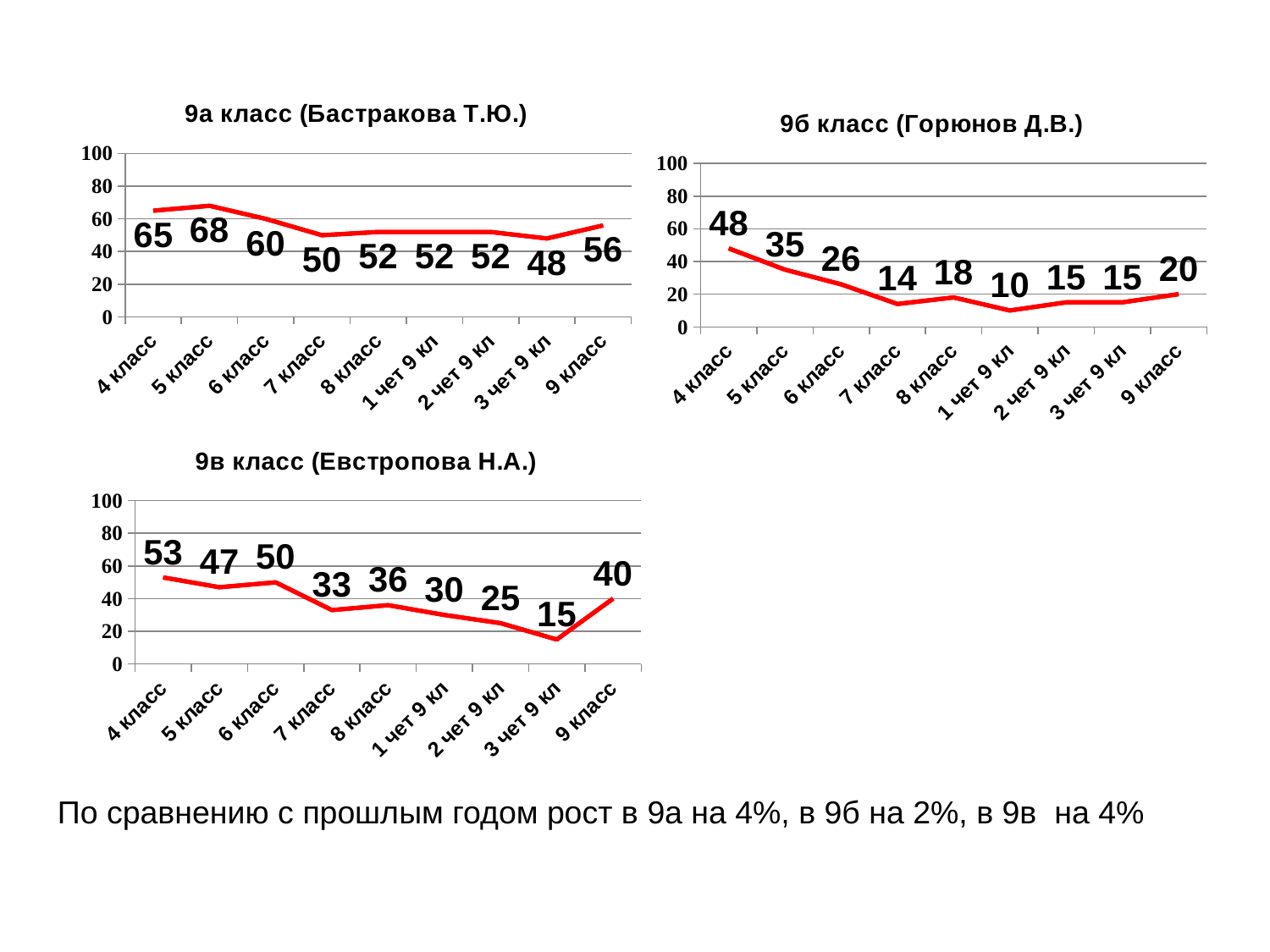
In the chart titled "9в класс (Евстропова Н.А.)", what is the difference between the values for 4 класс and 3 чет 9 кл? 38 In the chart titled "9в класс (Евстропова Н.А.)", what is the value for 8 класс? 36 What kind of chart is the chart titled "9б класс (Горюнов Д.В.)"? line chart In the chart titled "9б класс (Горюнов Д.В.)", do the values generally rise or fall from 4 класс to 7 класс? fall In the chart titled "9б класс (Горюнов Д.В.)", what is the value for 1 чет 9 кл? 10 In the chart titled "9в класс (Евстропова Н.А.)", which is larger, the value for 7 класс or the value for 9 класс? 9 класс In the chart titled "9а класс (Бастракова Т.Ю.)", what is the value for 5 класс? 68 In the chart titled "9б класс (Горюнов Д.В.)", which category has the highest value? 4 класс How many categories are shown on the x axis of the chart titled "9в класс (Евстропова Н.А.)"? 9 In the chart titled "9б класс (Горюнов Д.В.)", is the value for 4 класс greater or less than 40? greater In the chart titled "9а класс (Бастракова Т.Ю.)", what is the difference between the values for 5 класс and 9 класс? 12 In the chart titled "9а класс (Бастракова Т.Ю.)", which category has the lowest value? 3 чет 9 кл